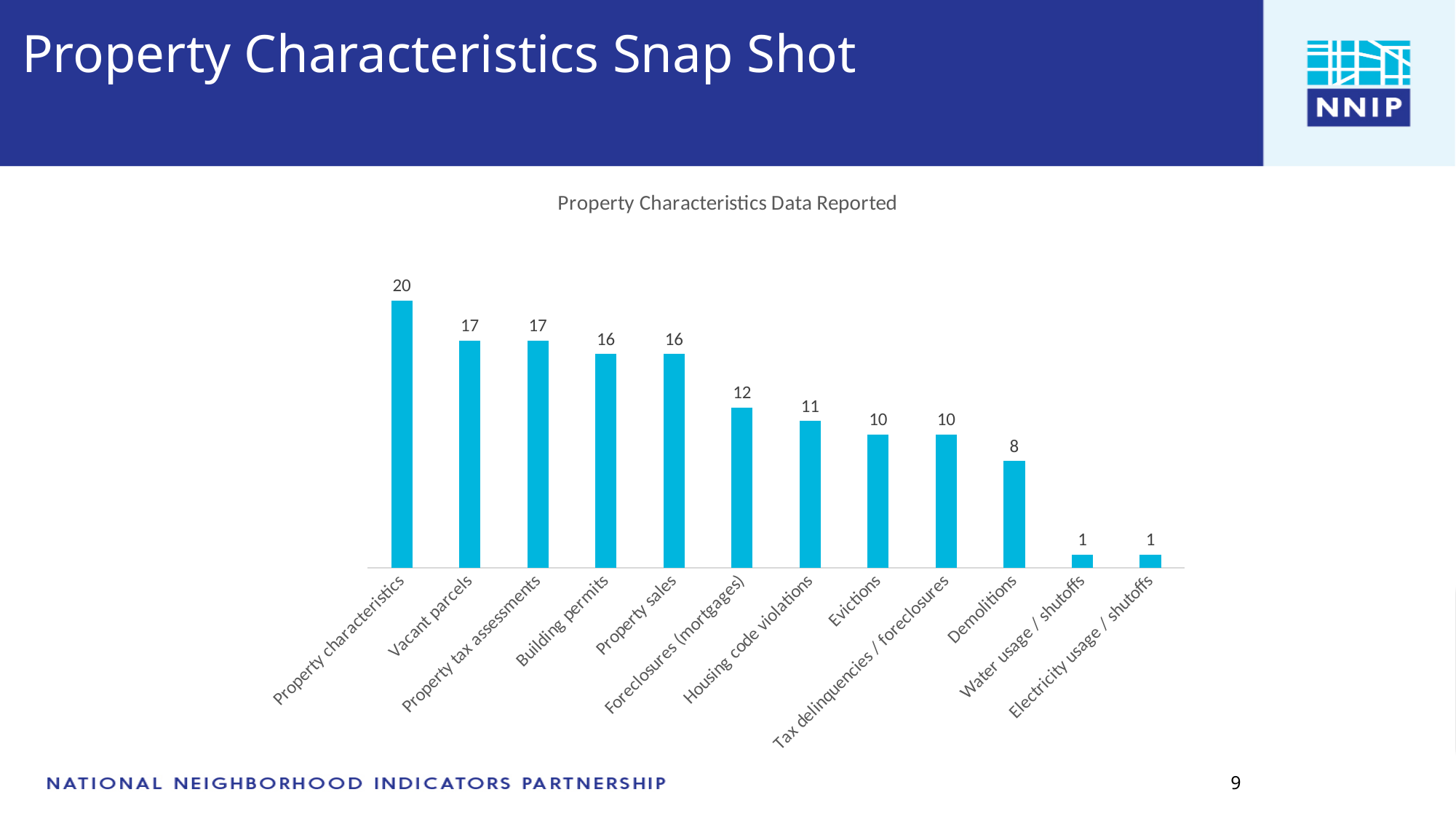
Which is larger, the value for Housing code violations or the value for Building permits? Building permits What is the value for Property characteristics? 20 What is the value for Foreclosures (mortgages)? 12 What kind of chart is shown on the slide? Bar chart How many categories are shown on the chart? 12 Which category has the highest value? Property characteristics What is the difference between the values for Vacant parcels and Evictions? 7 What is the difference between the values for Property characteristics and Demolitions? 12 What is the value for Water usage / shutoffs? 1 What is the title of the chart? Property Characteristics Data Reported Do the values rise or fall from left to right along the x axis? Fall What is the value for Demolitions? 8